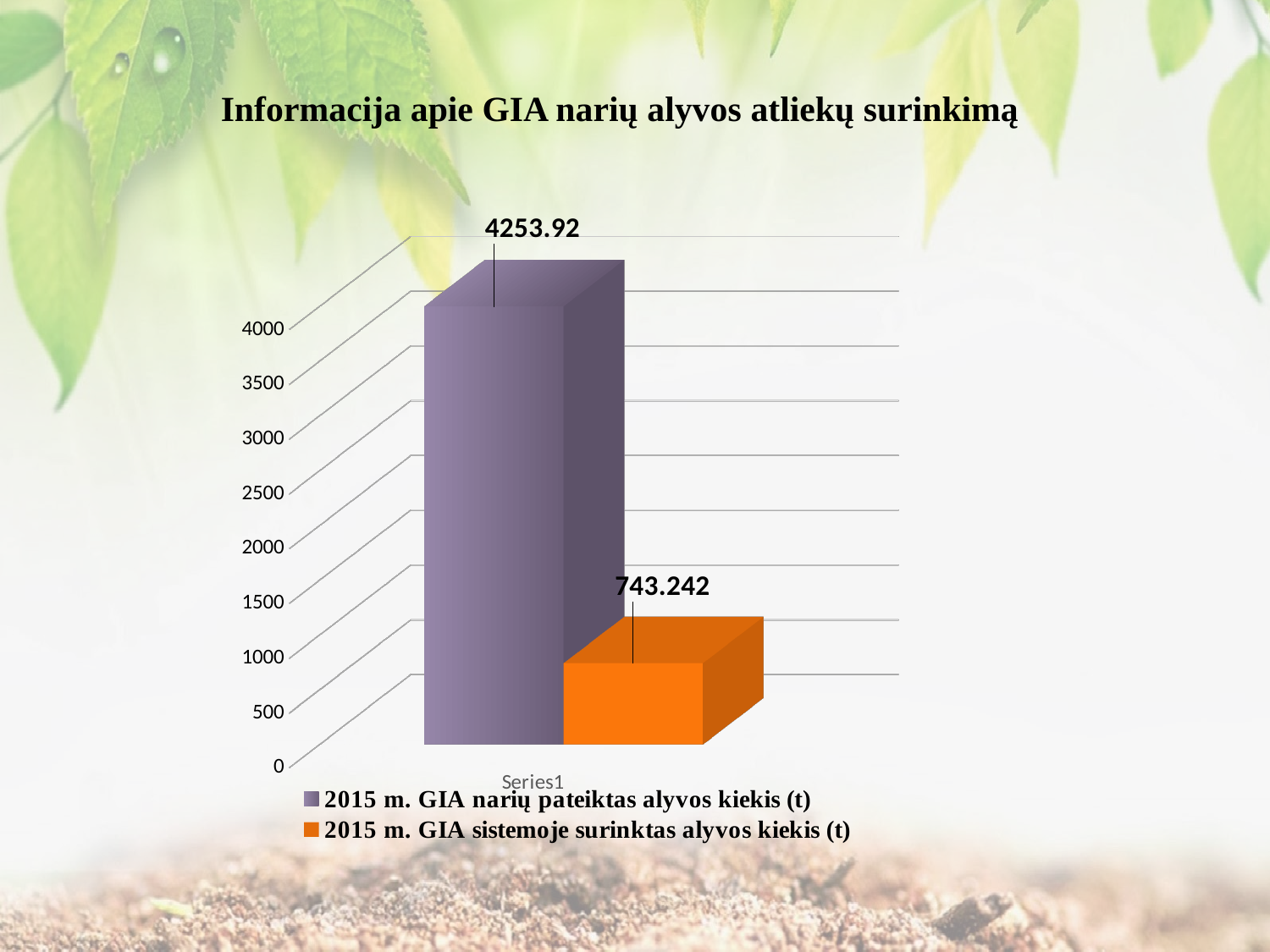
Is the value for '2015 m. GIA sistemoje surinktas alyvos kiekis (t)' greater or less than 1000? less What is the difference between the value for '2015 m. GIA narių pateiktas alyvos kiekis (t)' and the value for '2015 m. GIA sistemoje surinktas alyvos kiekis (t)'? 3510.678 What kind of chart is shown on the slide? bar chart Is the value for '2015 m. GIA narių pateiktas alyvos kiekis (t)' larger or smaller than the value for '2015 m. GIA sistemoje surinktas alyvos kiekis (t)'? larger What value is shown for '2015 m. GIA sistemoje surinktas alyvos kiekis (t)'? 743.242 How many series does the legend list? 2 What is the title of the slide containing the chart? Informacija apie GIA narių alyvos atliekų surinkimą Is the value for '2015 m. GIA narių pateiktas alyvos kiekis (t)' greater or less than 4000? greater Which series has the lower value? 2015 m. GIA sistemoje surinktas alyvos kiekis (t) What colour is the bar for '2015 m. GIA sistemoje surinktas alyvos kiekis (t)'? orange What value is shown for '2015 m. GIA narių pateiktas alyvos kiekis (t)'? 4253.92 Which series has the higher value? 2015 m. GIA narių pateiktas alyvos kiekis (t)